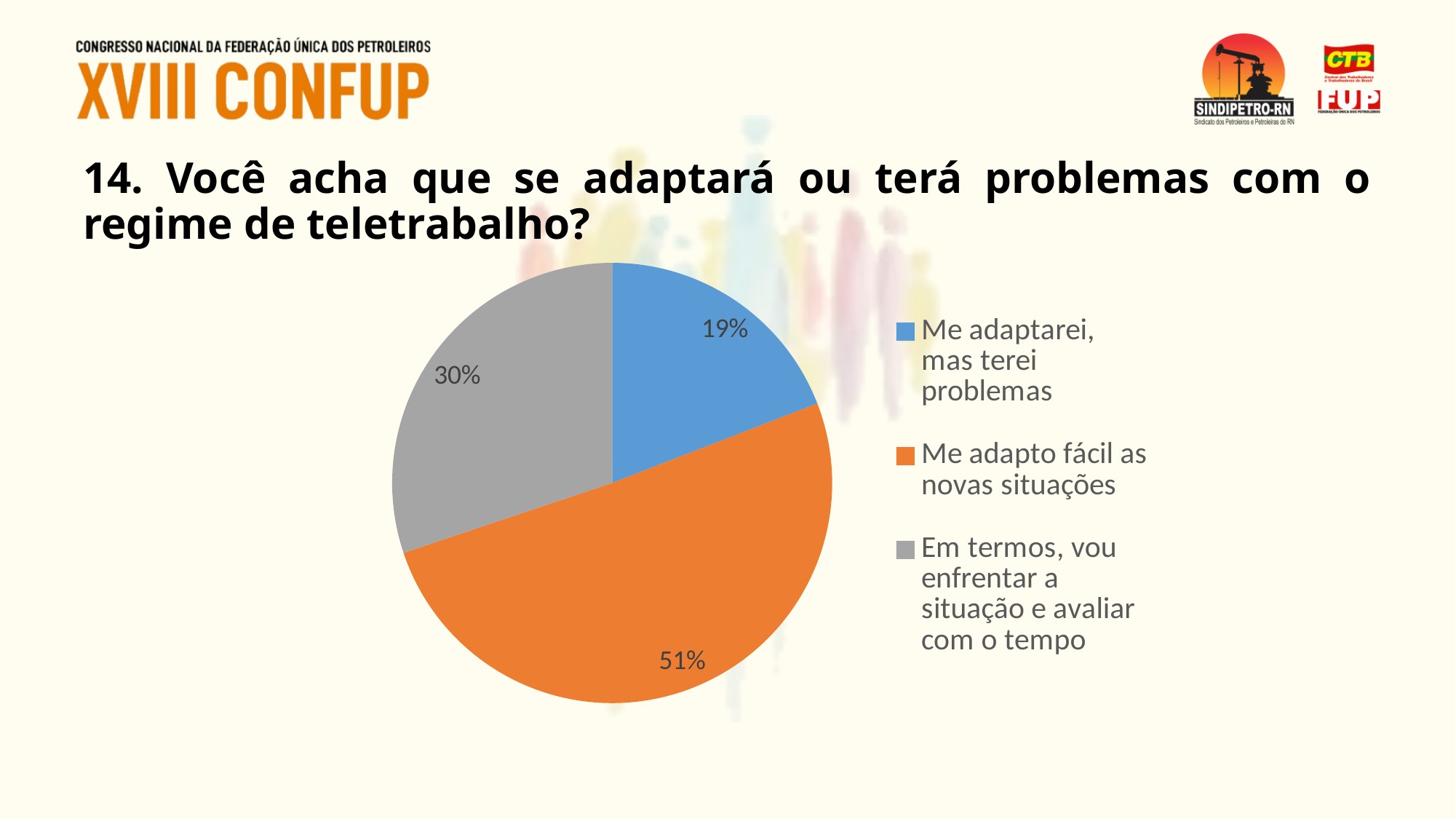
How many slices does the pie chart have? 3 Which category has the largest slice of the pie? Me adapto fácil as novas situações How many entries does the legend list? 3 Which is larger: the "Em termos, vou enfrentar a situação e avaliar com o tempo" slice or the "Me adaptarei, mas terei problemas" slice? Em termos, vou enfrentar a situação e avaliar com o tempo What share of the pie is labelled "Em termos, vou enfrentar a situação e avaliar com o tempo"? 30% What kind of chart is shown on the slide? pie chart What colour is the slice for "Em termos, vou enfrentar a situação e avaliar com o tempo"? grey What is the difference in percentage points between the "Me adapto fácil as novas situações" slice and the "Em termos, vou enfrentar a situação e avaliar com o tempo" slice? 21 percentage points What share of the pie is labelled "Me adaptarei, mas terei problemas"? 19% Which category has the smallest slice of the pie? Me adaptarei, mas terei problemas What share of the pie is labelled "Me adapto fácil as novas situações"? 51% What colour is the slice for "Me adapto fácil as novas situações"? orange